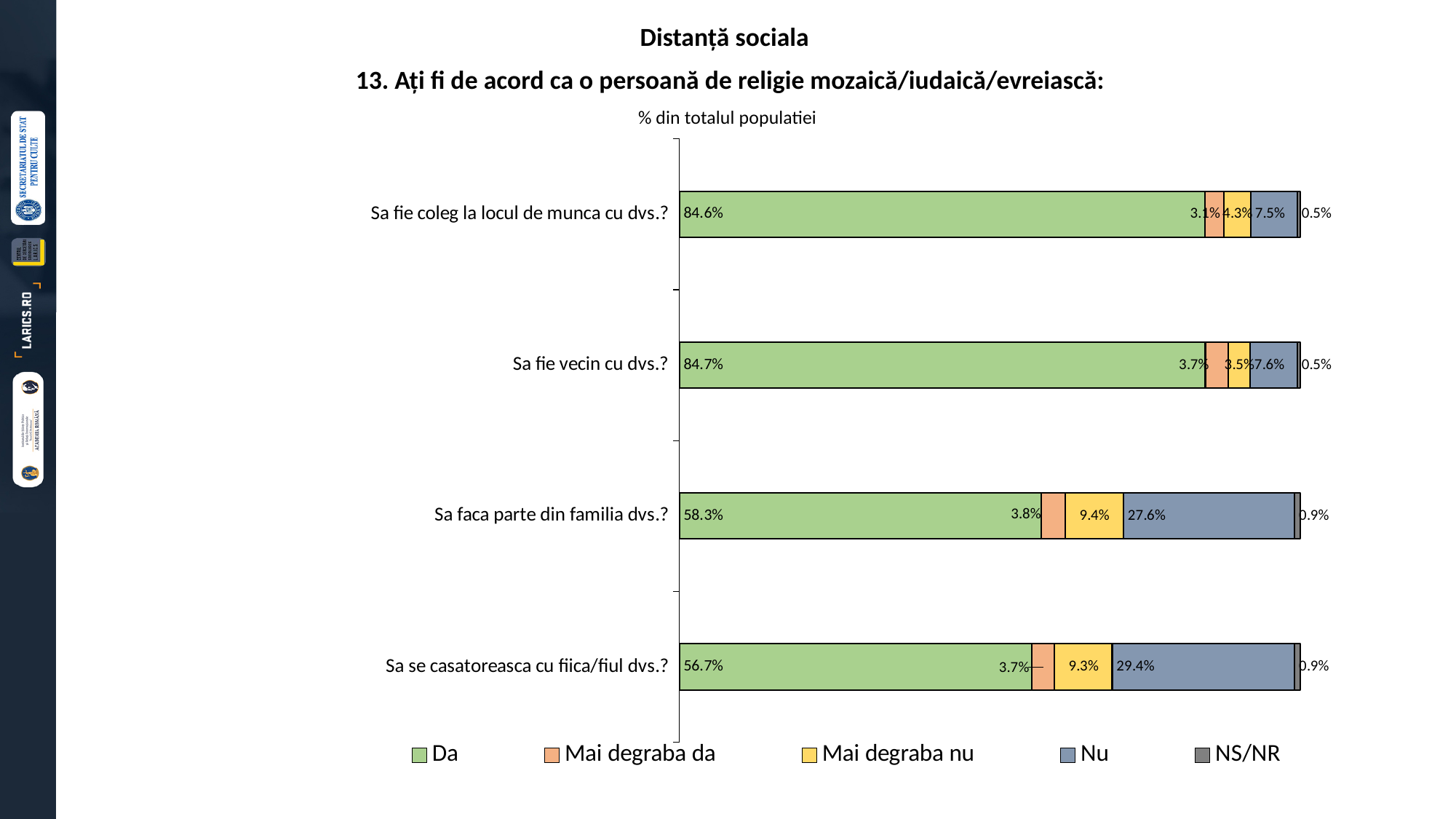
Which category has the lowest "Da" value? Sa se casatoreasca cu fiica/fiul dvs.? What percentage answered "Da" for "Sa fie coleg la locul de munca cu dvs.?"? 84.6% Which category has the highest "Nu" value? Sa se casatoreasca cu fiica/fiul dvs.? What is the "Mai degraba nu" value for "Sa faca parte din familia dvs.?"? 9.4% What is the total of the stacked bar for "Sa fie coleg la locul de munca cu dvs.?"? 100.0% How many series does the legend list? 5 What is the "NS/NR" value for "Sa fie vecin cu dvs.?"? 0.5% What kind of chart is shown on the slide? Stacked bar chart What is the difference between the "Nu" values for "Sa faca parte din familia dvs.?" and "Sa fie coleg la locul de munca cu dvs.?"? 20.1% Which is larger: the "Mai degraba nu" value for "Sa fie coleg la locul de munca cu dvs.?" or for "Sa fie vecin cu dvs.?"? Sa fie coleg la locul de munca cu dvs.? What is the "Nu" value for "Sa se casatoreasca cu fiica/fiul dvs.?"? 29.4% How many categories (bars) are shown in the chart? 4